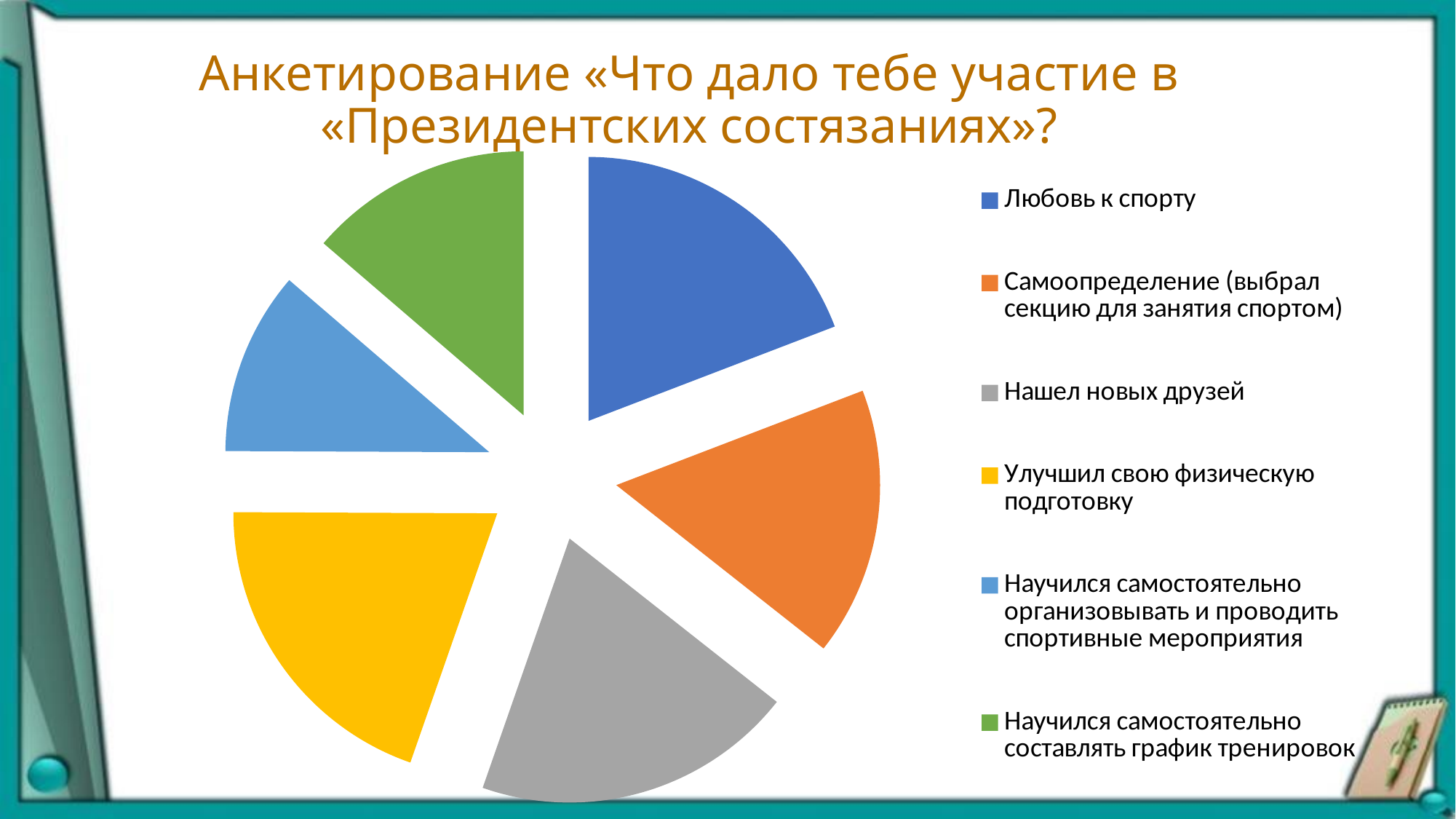
How many entries does the legend of the pie chart list? 6 Which slice is larger: "Любовь к спорту" or "Научился самостоятельно организовывать и проводить спортивные мероприятия"? Любовь к спорту Which slice is larger: "Улучшил свою физическую подготовку" or "Научился самостоятельно составлять график тренировок"? Улучшил свою физическую подготовку What kind of chart is shown on the slide? pie chart How many slices does the pie chart have? 6 Which slice is larger: "Нашел новых друзей" or "Научился самостоятельно организовывать и проводить спортивные мероприятия"? Нашел новых друзей What is the title of the slide containing the pie chart? Анкетирование «Что дало тебе участие в «Президентских состязаниях»? What colour is the slice for "Нашел новых друзей" in the pie chart? gray